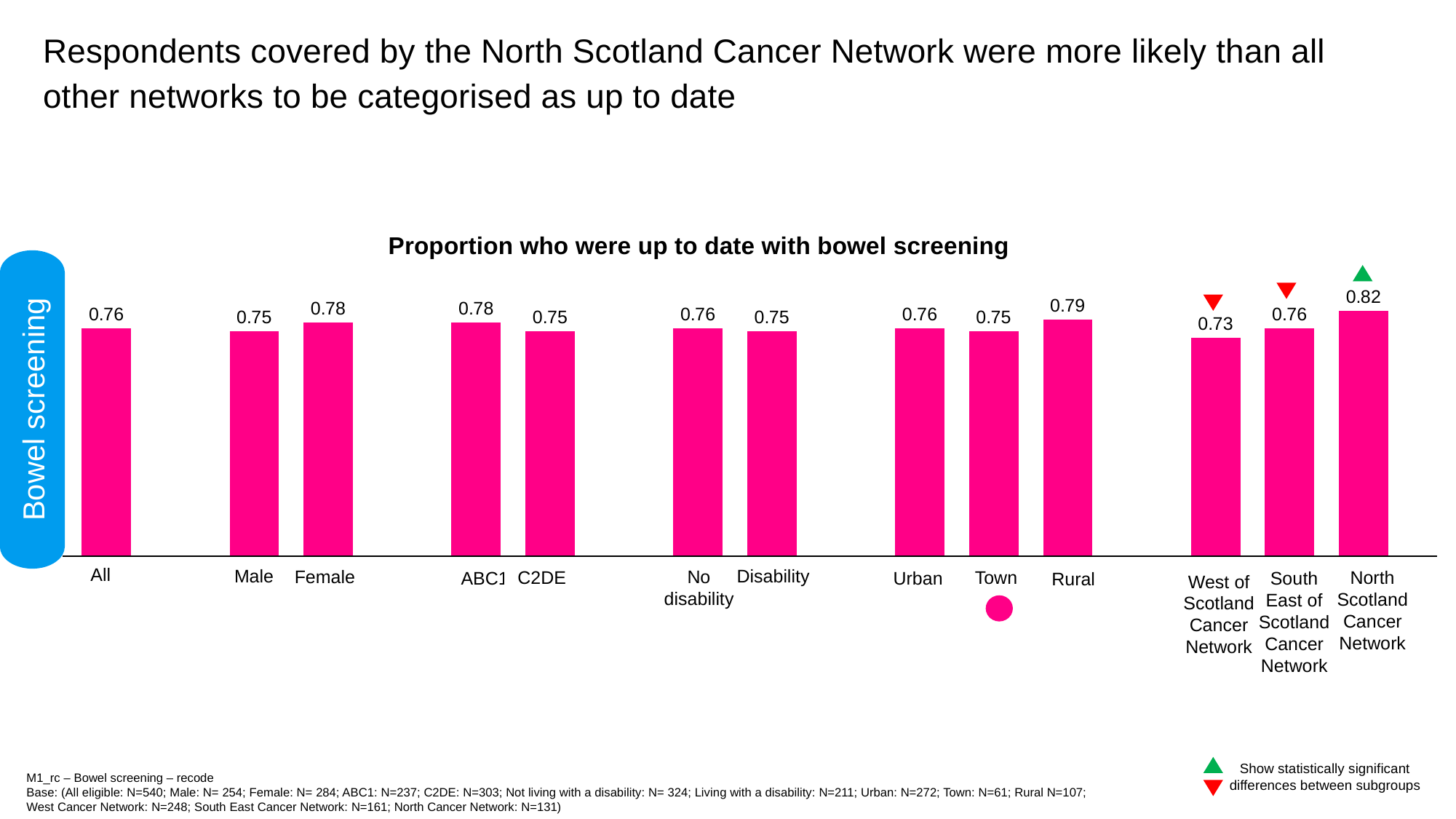
What is the value for West of Scotland Cancer Network? 0.73 What is the difference between the values for Female and Male? 0.03 Which category has the lowest value in the chart? West of Scotland Cancer Network What is the difference between the values for North Scotland Cancer Network and West of Scotland Cancer Network? 0.09 What is the value for North Scotland Cancer Network? 0.82 What is the value for Rural? 0.79 What is the value for All in the chart 'Proportion who were up to date with bowel screening'? 0.76 How many categories (bars) are plotted in the chart? 13 Which is larger, the value for ABC1 or the value for C2DE? ABC1 Which category has the highest value in the chart? North Scotland Cancer Network What is the title of the chart? Proportion who were up to date with bowel screening What kind of chart is shown on the slide? Bar chart